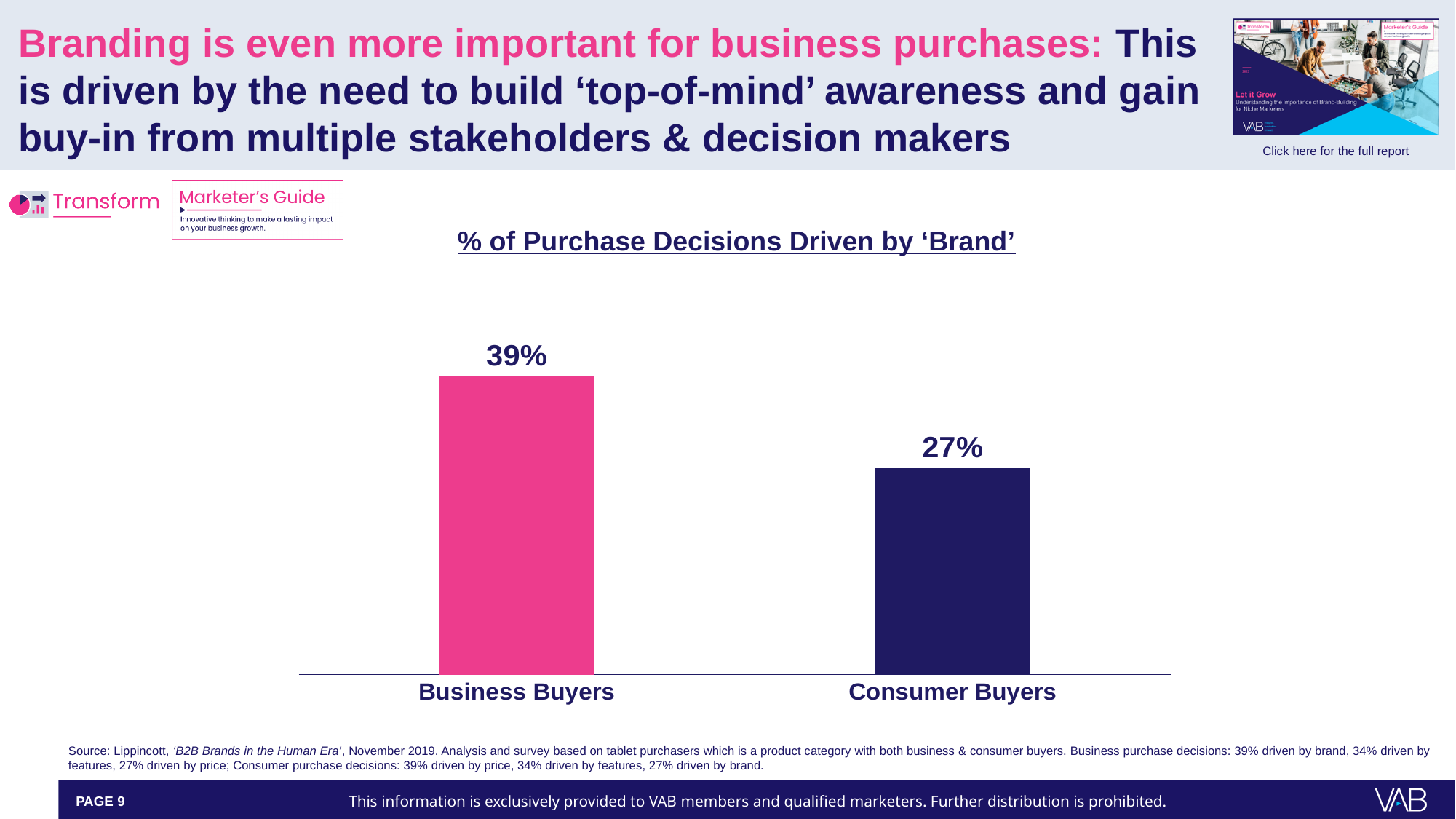
What kind of chart is shown on the slide? bar chart What is the title of the chart? % of Purchase Decisions Driven by 'Brand' Which category has the higher percentage of purchase decisions driven by brand? Business Buyers Is the value for Business Buyers larger or smaller than the value for Consumer Buyers? larger What colour is the bar for Business Buyers? pink How many categories are shown in the chart? 2 What percentage of purchase decisions are driven by brand for Business Buyers? 39% What is the difference in percentage points between Business Buyers and Consumer Buyers? 12 percentage points What percentage of purchase decisions are driven by brand for Consumer Buyers? 27% Which category has the lower percentage of purchase decisions driven by brand? Consumer Buyers